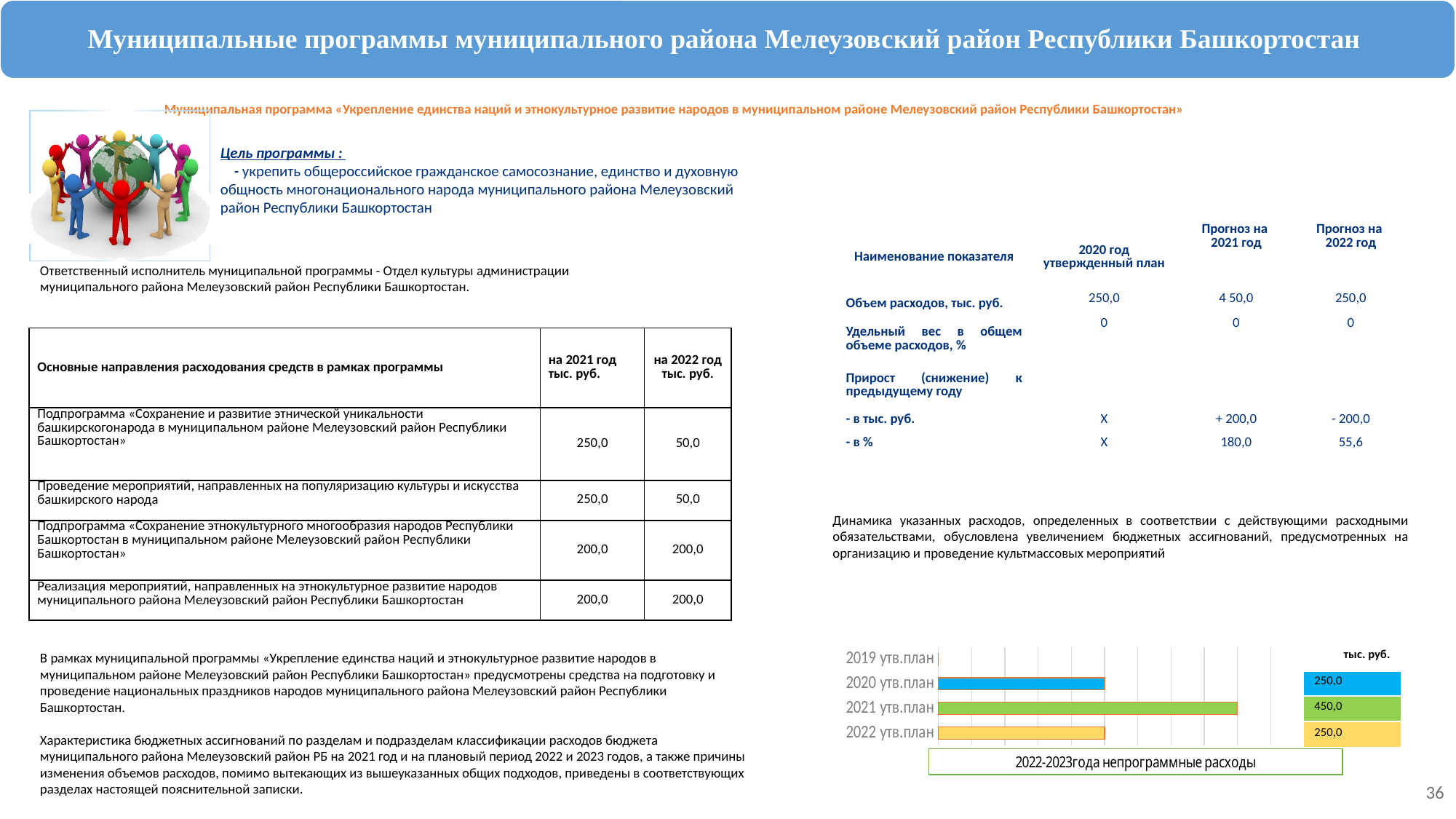
Does the value rise or fall from 2020 утв.план to 2021 утв.план in the bar chart? Rise Does the value rise or fall from 2021 утв.план to 2022 утв.план in the bar chart? Fall What is the value for 2022 утв.план in the bar chart? 250,0 What unit is indicated above the value labels of the bar chart? тыс. руб. What is the value for 2021 утв.план in the bar chart? 450,0 What is the difference between the values for 2021 утв.план and 2020 утв.план in the bar chart? 200,0 What colour is the bar for 2021 утв.план in the bar chart? Green What kind of chart is shown at the bottom right of the slide? Bar chart How many categories are shown on the vertical axis of the bar chart? 4 Which category has the highest value in the bar chart? 2021 утв.план Which is larger in the bar chart: the value for 2021 утв.план or 2022 утв.план? 2021 утв.план What is the value for 2020 утв.план in the bar chart? 250,0